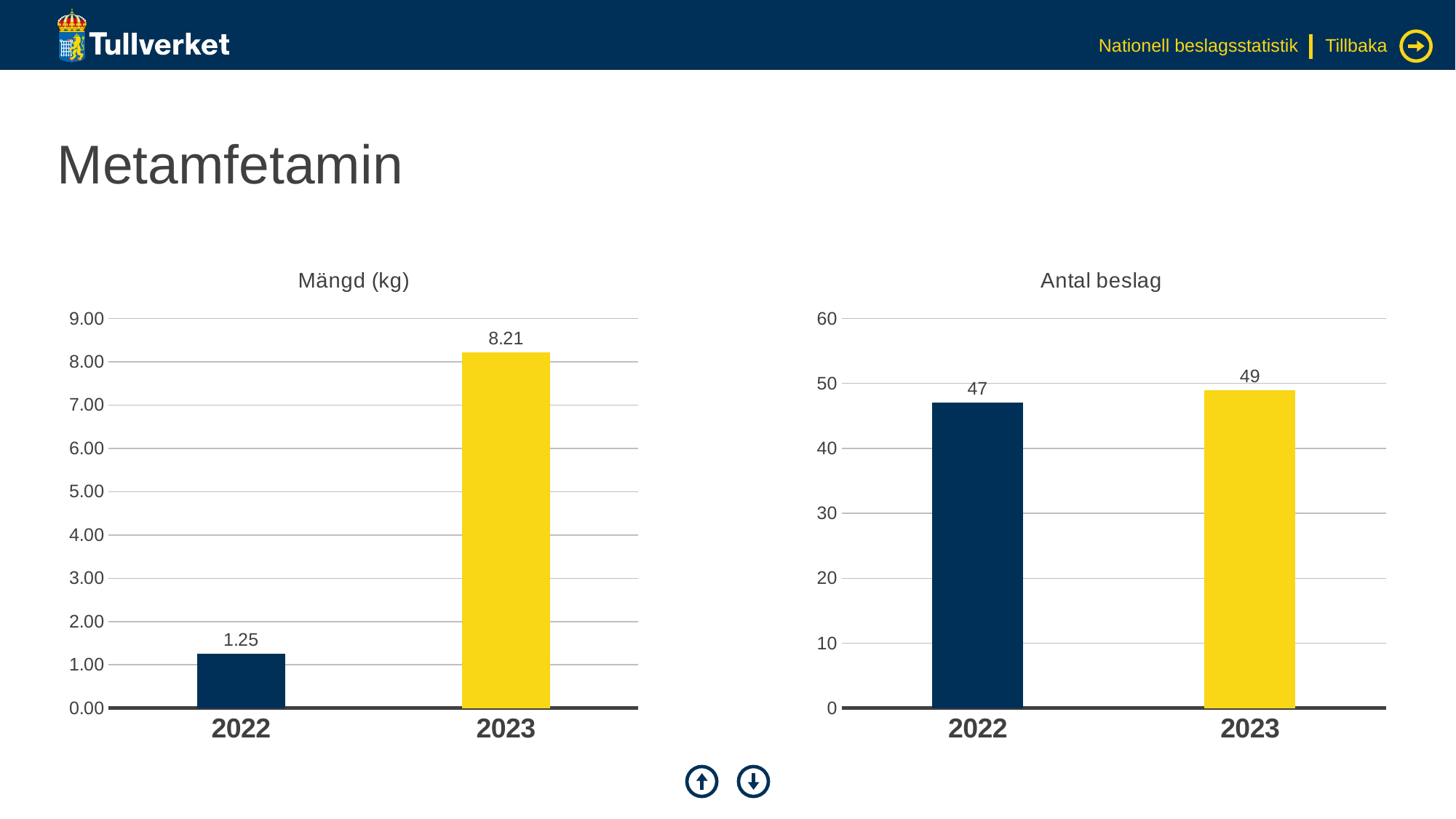
In the 'Mängd (kg)' chart, what is the difference between the 2023 and 2022 values? 6.96 In the 'Antal beslag' chart, what is the value for 2023? 49 In the 'Antal beslag' chart, what is the difference between the 2023 and 2022 values? 2 In the 'Mängd (kg)' chart, what is the value for 2022? 1.25 In the 'Mängd (kg)' chart, which year has the highest value? 2023 In the 'Mängd (kg)' chart, what is the value for 2023? 8.21 In the 'Antal beslag' chart, which year has the lowest value? 2022 In the 'Antal beslag' chart, what is the value for 2022? 47 In the 'Mängd (kg)' chart, is the value for 2023 greater or less than 8.00? greater In the 'Antal beslag' chart, do the values rise or fall from 2022 to 2023? rise What kind of chart is the 'Mängd (kg)' chart? bar chart How many categories are shown on the x axis of the 'Antal beslag' chart? 2